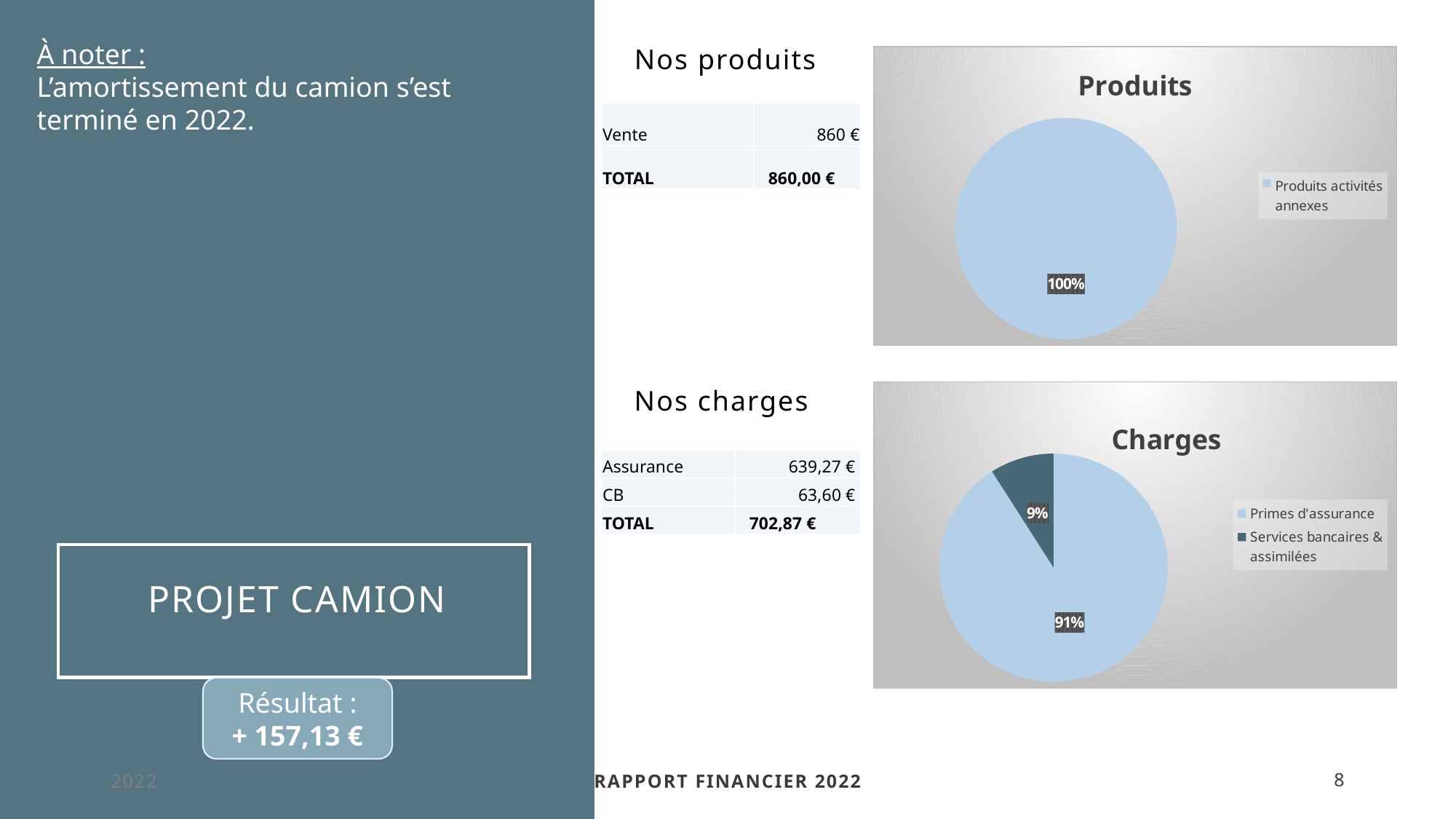
How many slices does the "Produits" chart have? 1 In the "Charges" chart, which slice is the smallest? Services bancaires & assimilées In the "Charges" chart, what share does "Services bancaires & assimilées" have? 9% How many entries does the legend of the "Produits" chart list? 1 In the "Produits" chart, what share does "Produits activités annexes" have? 100% How many entries does the legend of the "Charges" chart list? 2 What kind of chart is the "Charges" chart? pie chart In the "Charges" chart, which slice is the largest? Primes d'assurance What kind of chart is the "Produits" chart? pie chart In the "Charges" chart, what share does "Primes d'assurance" have? 91% How many slices does the "Charges" chart have? 2 In the "Charges" chart, what is the difference in percentage points between "Primes d'assurance" and "Services bancaires & assimilées"? 82